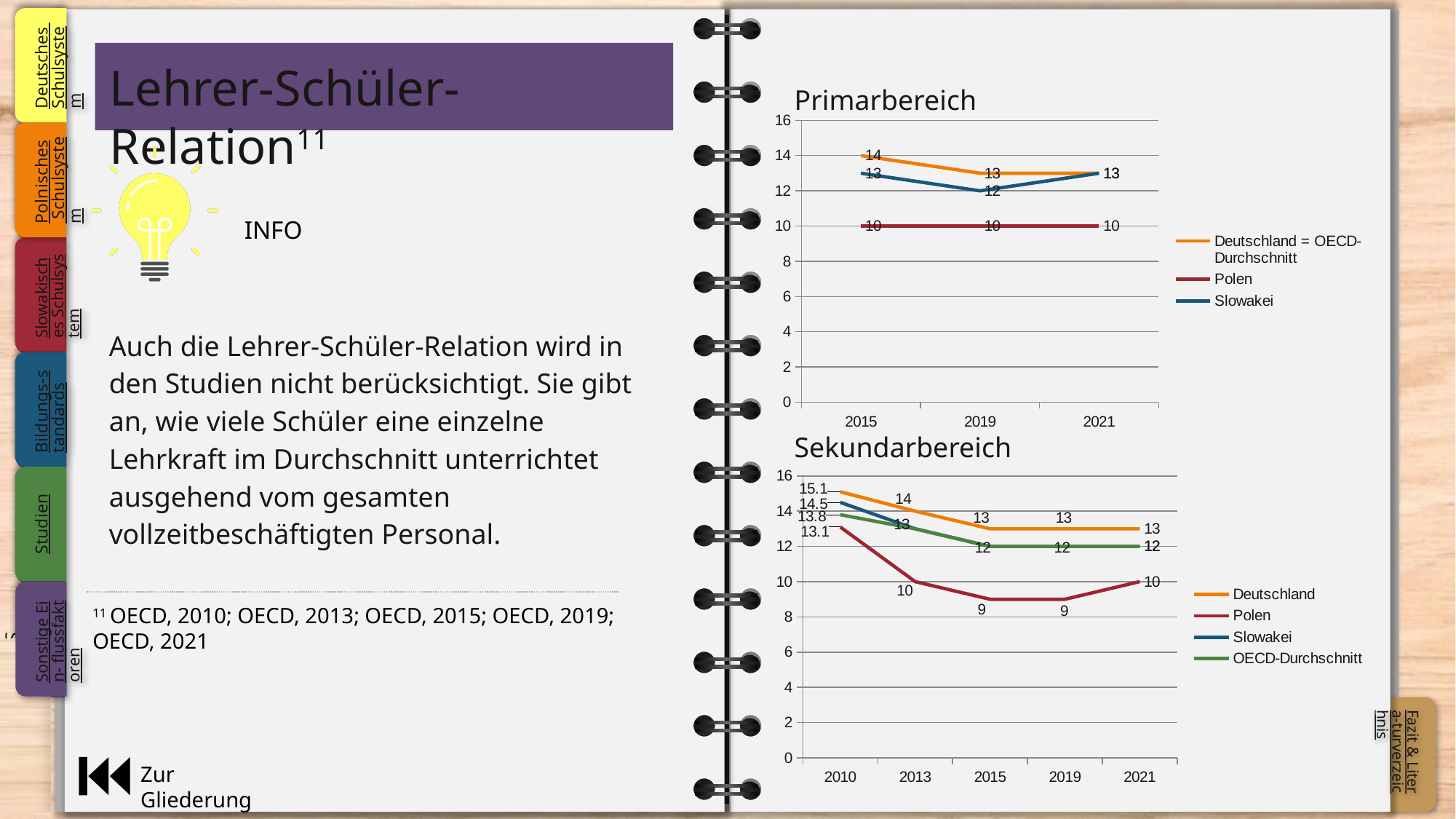
In the Primarbereich chart, how many series does the legend list? 3 In the Primarbereich chart, what is the difference between Deutschland = OECD-Durchschnitt and Polen in 2015? 4 In the Sekundarbereich chart, which series has the highest value in 2021? Deutschland In the Sekundarbereich chart, what is the value for Polen in 2015? 9 In the Sekundarbereich chart, what is the value for Deutschland in 2010? 15.1 In the Sekundarbereich chart, how many years are shown on the x axis? 5 In the Primarbereich chart, what is the value for Slowakei in 2019? 12 In the Primarbereich chart, what is the value for Deutschland = OECD-Durchschnitt in 2015? 14 What kind of chart is the Sekundarbereich chart? Line chart In the Sekundarbereich chart, does the value for Polen rise or fall from 2010 to 2015? Fall In the Primarbereich chart, which series has the lowest value in 2021? Polen In the Primarbereich chart, what is the value for Polen in 2019? 10